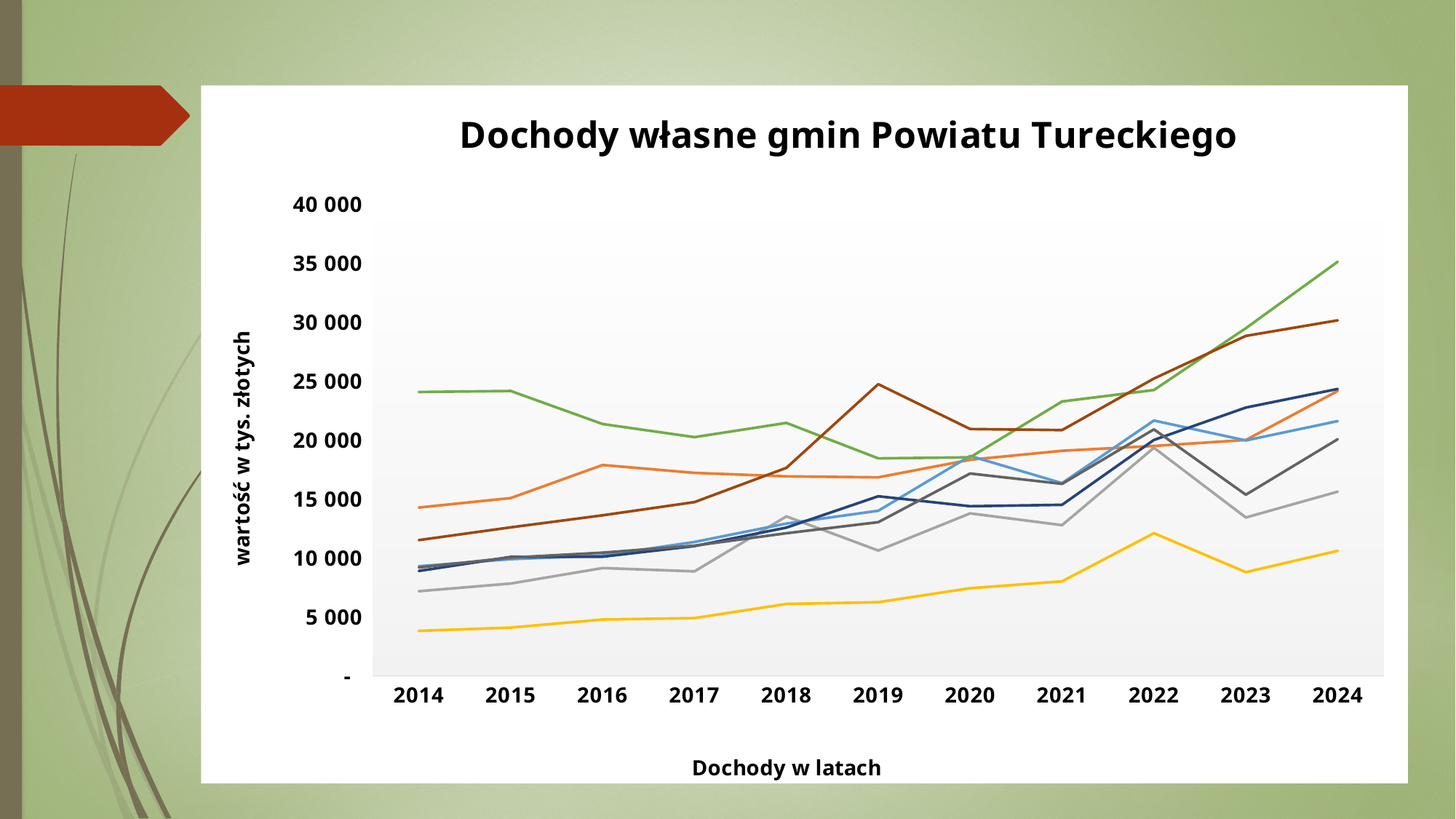
Which line is the lowest in 2024? the yellow line Which line is the highest in 2024? the green line Is the value of the yellow line in 2024 greater or less than 15 000? less What is the label on the vertical axis of the chart? wartość w tys. złotych What kind of chart is shown on the slide? line chart Is the value of the green line in 2024 greater or less than 30 000? greater How many years are shown along the x axis of the chart? 11 Is the value of the yellow line in 2014 greater or less than 5 000? less In 2019, which is larger: the value of the brown line or the value of the green line? the brown line Which line is the highest in 2019? the brown line Does the yellow line generally rise or fall from 2014 to 2024? rise What is the title of the chart? Dochody własne gmin Powiatu Tureckiego